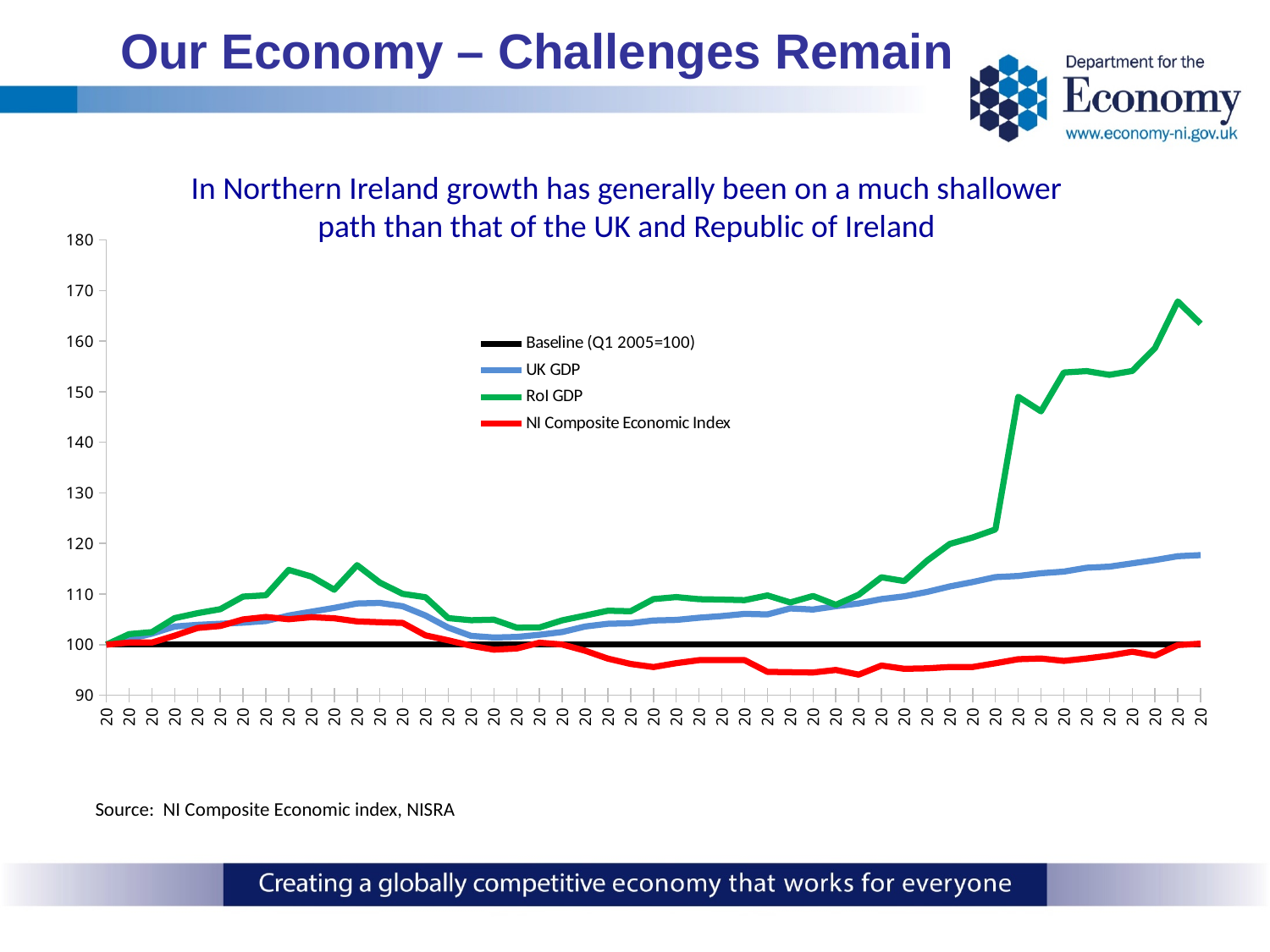
What value is the Baseline series set to, according to the legend? 100 What is the source given below the chart? NI Composite Economic index, NISRA At the right-hand end of the chart, is the value for RoI GDP greater or less than 160? greater At its lowest point, is the NI Composite Economic Index greater or less than 100? less How many series does the chart legend list? 4 Which series reaches the highest value on the chart? RoI GDP What colour is the line for the NI Composite Economic Index? Red At the right-hand end of the chart, which is higher, UK GDP or the NI Composite Economic Index? UK GDP At the right-hand end of the chart, is the value for UK GDP greater or less than 120? less What type of chart is shown on the slide? Line chart Does RoI GDP overall rise or fall from the left to the right of the chart? Rise